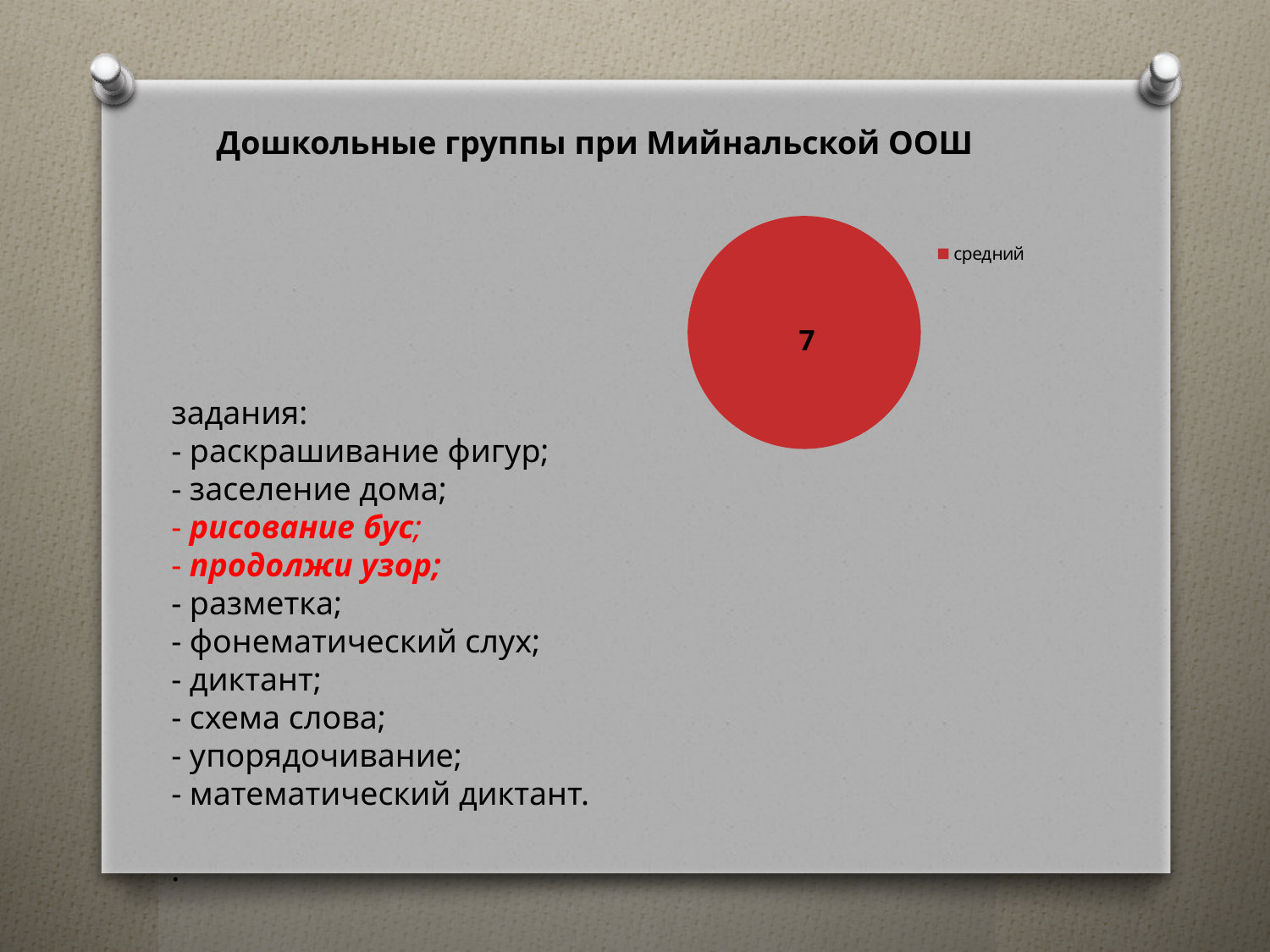
How many slices does the pie chart have? 1 What is the only category named in the pie chart's legend? средний What kind of chart is shown on the slide? pie chart Is the value shown on the pie chart greater or less than 5? greater What share of the pie does the "средний" slice take up? 100% What colour is the "средний" slice in the pie chart? red How many entries does the legend of the pie chart list? 1 What value is shown for the slice labelled "средний" in the pie chart? 7